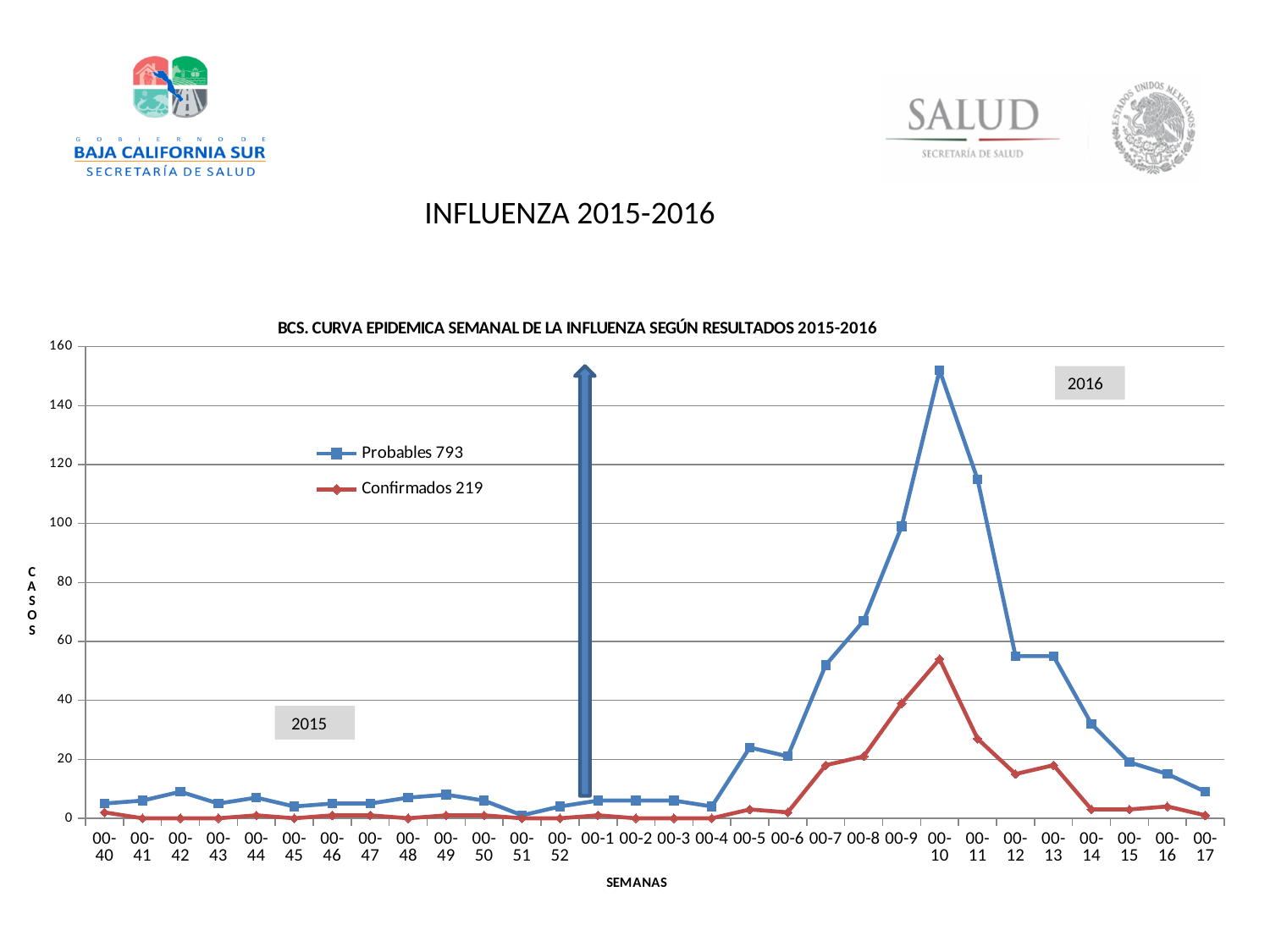
How many series does the legend list? 2 In which week is the Probables series at its lowest value? 00-51 In which week does the Probables series reach its highest value? 00-10 In which week does the Confirmados series reach its highest value? 00-10 Is the value for Probables in week 00-10 greater or less than 140? greater From week 00-10 to week 00-17, do the Probables values rise or fall? fall How many weeks (x-axis categories) are plotted on the chart? 30 Is the value for Confirmados in week 00-10 greater or less than 60? less What kind of chart is shown on the slide? line chart Is the value for Probables in week 00-11 greater or less than 100? greater What are the two series named in the legend? Probables 793 and Confirmados 219 In week 00-10, which series has the larger value, Probables or Confirmados? Probables